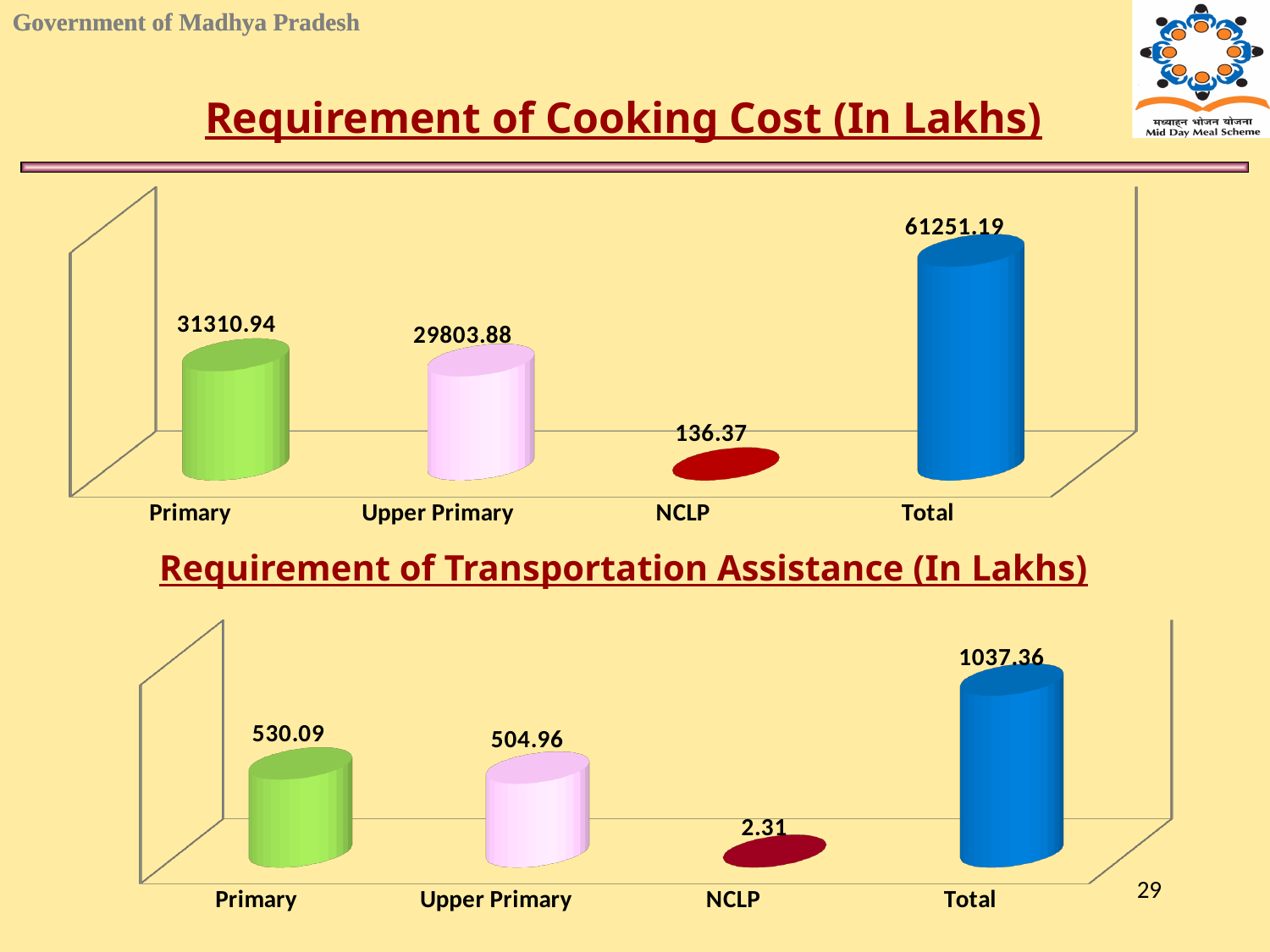
In the Requirement of Transportation Assistance chart, what is the value for NCLP? 2.31 In the Requirement of Cooking Cost chart, what is the difference between the Primary and Upper Primary values? 1507.06 In the Requirement of Cooking Cost chart, which category has the lowest value? NCLP In the Requirement of Transportation Assistance chart, which is larger, Primary or Upper Primary? Primary In the Requirement of Cooking Cost chart, what is the value for Primary? 31310.94 In the Requirement of Transportation Assistance chart, which category has the highest value? Total In the Requirement of Cooking Cost chart, what is the value for Total? 61251.19 In the Requirement of Transportation Assistance chart, what is the value for Upper Primary? 504.96 In the Requirement of Transportation Assistance chart, what is the difference between the Primary and Upper Primary values? 25.13 What type of chart is the Requirement of Transportation Assistance chart? Bar chart In the Requirement of Cooking Cost chart, what is the value for NCLP? 136.37 How many categories are shown in the Requirement of Cooking Cost chart? 4